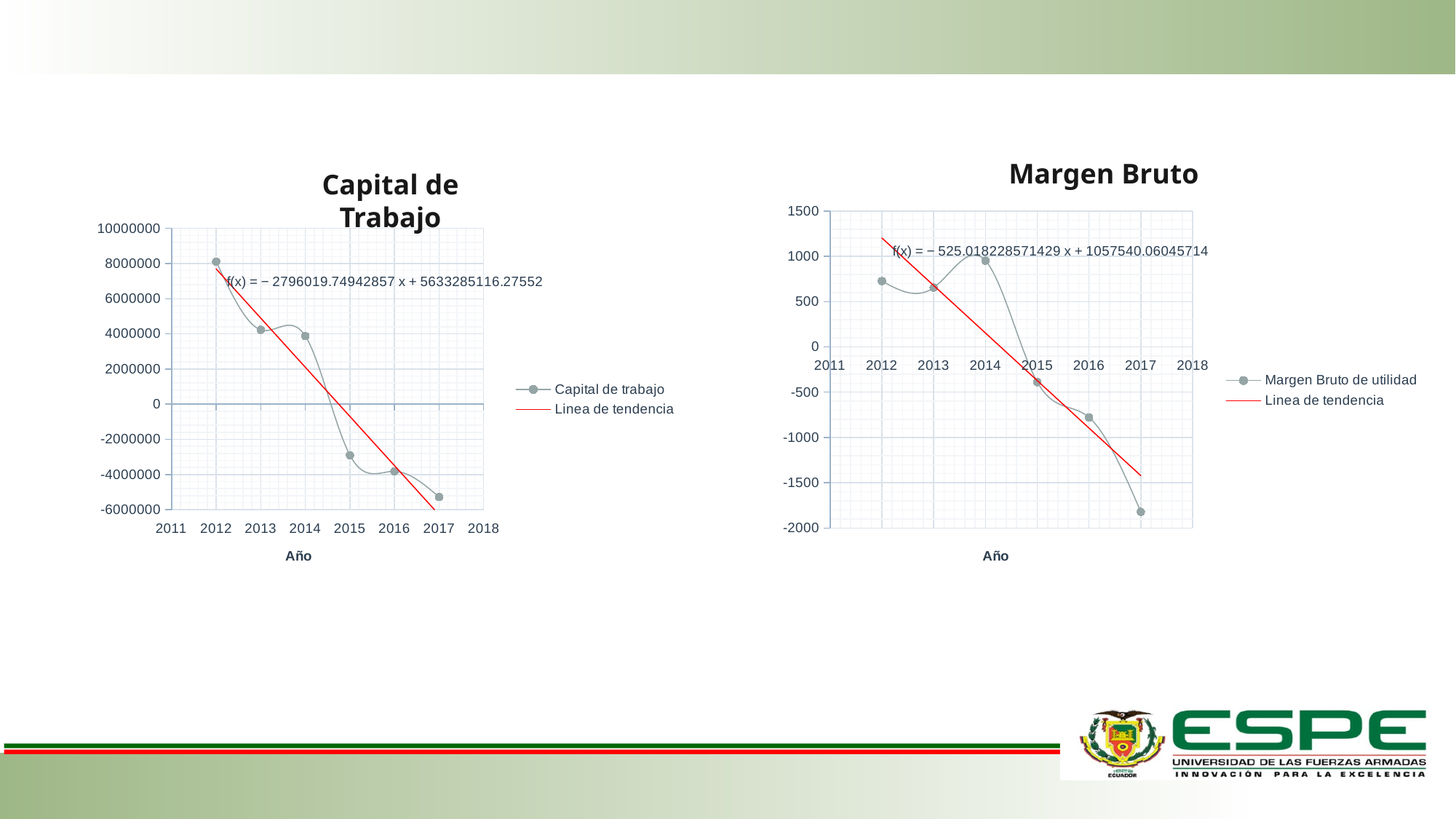
In the 'Capital de Trabajo' chart, is the value for 2012 greater or less than 6000000? greater In the 'Capital de Trabajo' chart, which year has the lowest value for Capital de trabajo? 2017 How many data points are plotted for Capital de trabajo in the 'Capital de Trabajo' chart? 6 In the 'Margen Bruto' chart, is the value for 2016 greater or less than -500? less In the 'Margen Bruto' chart, do the values for Margen Bruto de utilidad generally rise or fall from 2012 to 2017? fall How many series does the legend of the 'Margen Bruto' chart list? 2 In the 'Margen Bruto' chart, which year has the highest value for Margen Bruto de utilidad? 2014 In the 'Margen Bruto' chart, which year has the larger value: 2013 or 2014? 2014 In the 'Margen Bruto' chart, which year has the lowest value for Margen Bruto de utilidad? 2017 In the 'Capital de Trabajo' chart, which year has the highest value for Capital de trabajo? 2012 What kind of chart is the 'Capital de Trabajo' chart? line chart In the 'Capital de Trabajo' chart, is the value for 2015 greater or less than 0? less